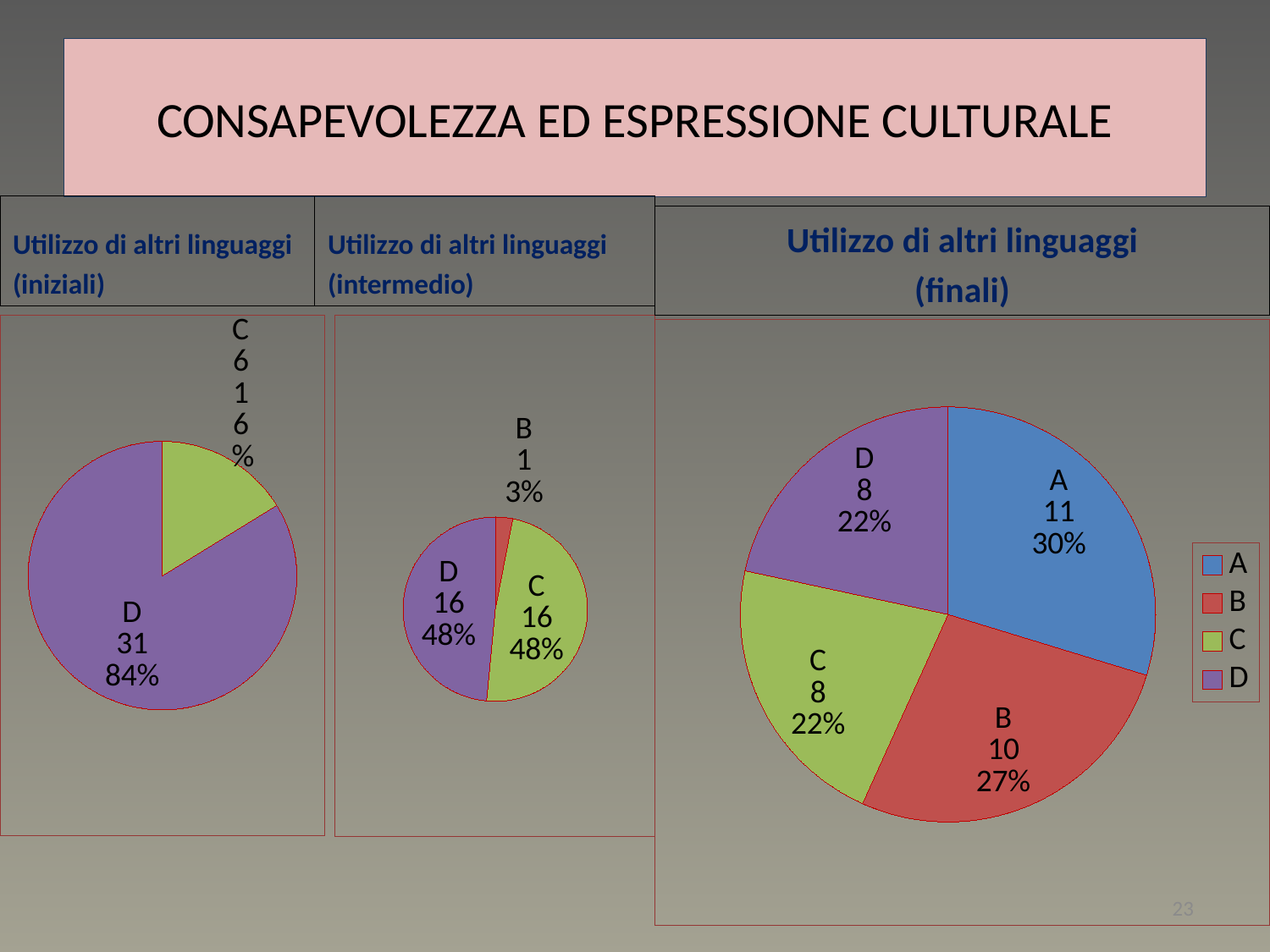
In the 'Utilizzo di altri linguaggi (finali)' chart, how many slices does the pie have? 4 In the 'Utilizzo di altri linguaggi (intermedio)' chart, which category has the smallest slice? B In the 'Utilizzo di altri linguaggi (intermedio)' chart, what share of the pie does D have? 48% In the 'Utilizzo di altri linguaggi (iniziali)' chart, what share of the pie does C have? 16% In the 'Utilizzo di altri linguaggi (finali)' chart, what value is shown for A? 11 In the 'Utilizzo di altri linguaggi (intermedio)' chart, what value is shown for B? 1 In the 'Utilizzo di altri linguaggi (iniziali)' chart, which is larger, the value for C or the value for D? D In the 'Utilizzo di altri linguaggi (finali)' chart, what is the difference between the values for A and C? 3 In the 'Utilizzo di altri linguaggi (iniziali)' chart, what value is shown for D? 31 In the 'Utilizzo di altri linguaggi (finali)' chart, which category has the largest slice? A How many entries does the legend of the 'Utilizzo di altri linguaggi (finali)' chart list? 4 What kind of chart is the 'Utilizzo di altri linguaggi (finali)' chart? Pie chart